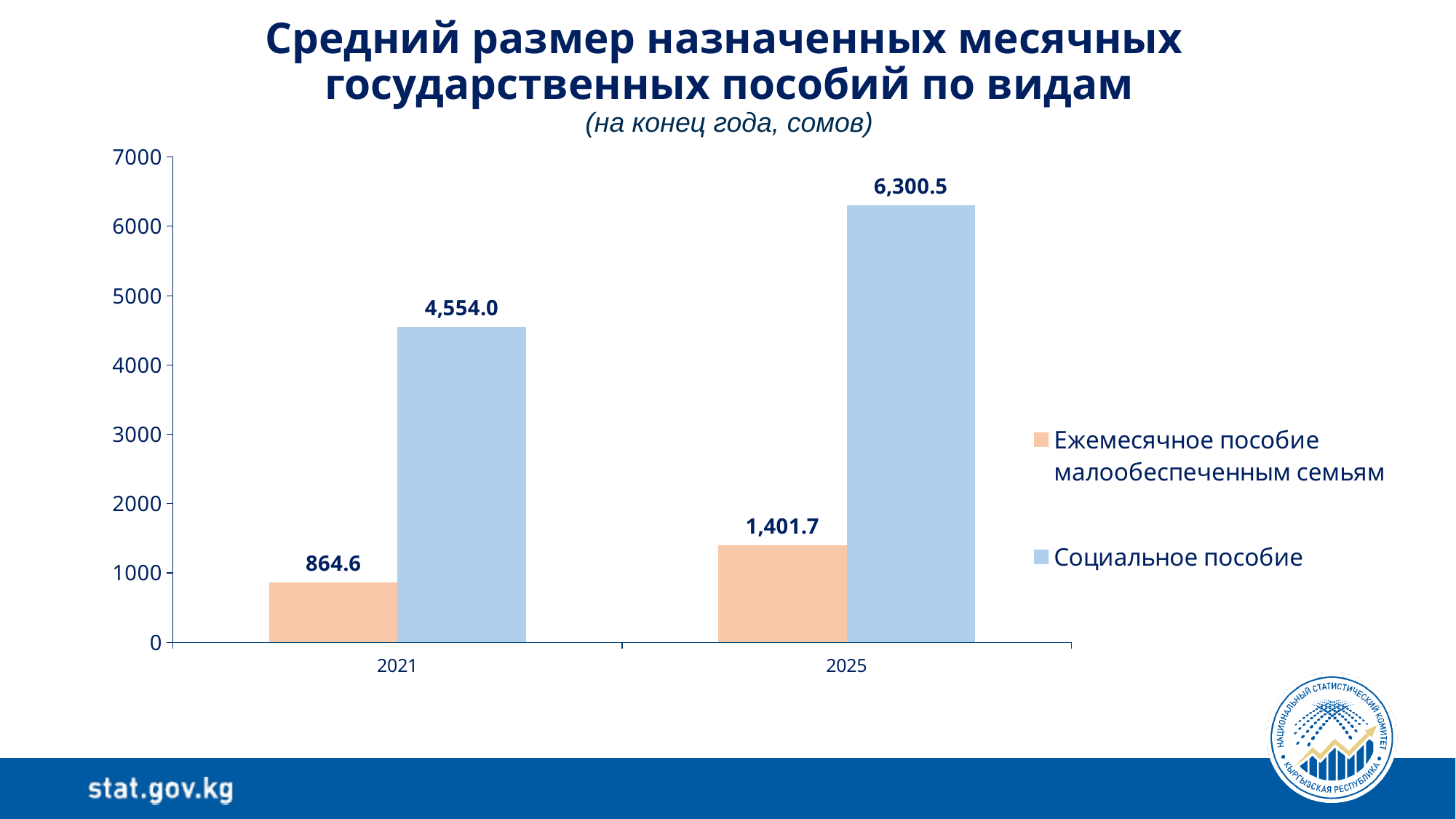
What is the value of Ежемесячное пособие малообеспеченным семьям in 2021? 864.6 What kind of chart is shown on the slide? Bar chart Which year has the highest value for Социальное пособие? 2025 What is the difference between Социальное пособие in 2025 and in 2021? 1,746.5 How many series does the legend list? 2 What is the difference between Социальное пособие and Ежемесячное пособие малообеспеченным семьям in 2025? 4,898.8 What is the value of Ежемесячное пособие малообеспеченным семьям in 2025? 1,401.7 Which year has the lowest value for Ежемесячное пособие малообеспеченным семьям? 2021 Does the value for Ежемесячное пособие малообеспеченным семьям rise or fall from 2021 to 2025? Rise Which is larger in 2021: Социальное пособие or Ежемесячное пособие малообеспеченным семьям? Социальное пособие What is the value of Социальное пособие in 2025? 6,300.5 What is the value of Социальное пособие in 2021? 4,554.0